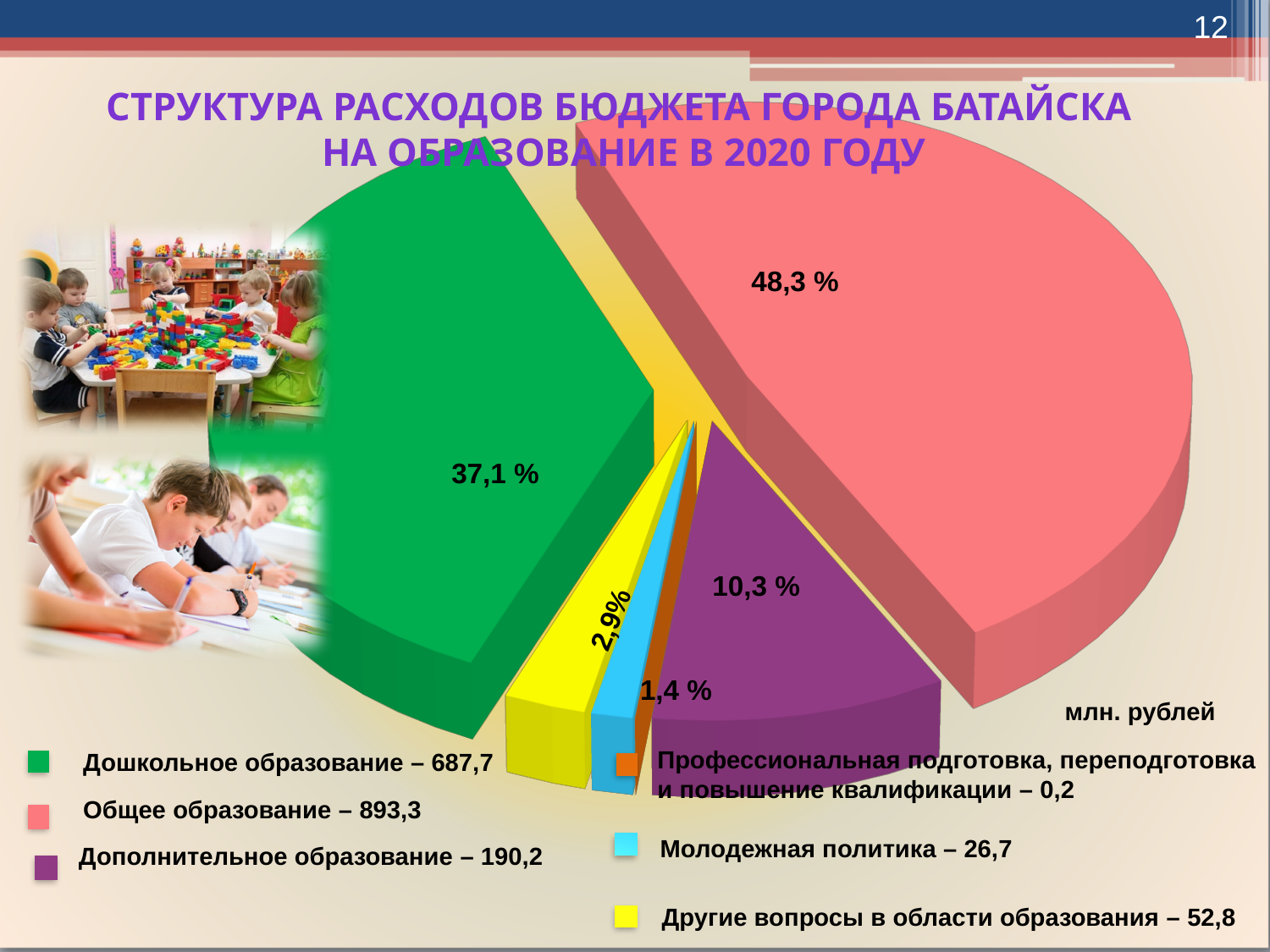
Which category has the largest share of the pie? Общее образование What share of the pie does Дополнительное образование take? 10,3 % Which category has the smallest value in the legend? Профессиональная подготовка, переподготовка и повышение квалификации What value in млн. рублей does the legend give for Дошкольное образование? 687,7 What share of the pie does Дошкольное образование take? 37,1 % Which colour represents Дополнительное образование in the pie chart? purple What is the difference in млн. рублей between Общее образование and Дошкольное образование? 205,6 What share of the pie does Общее образование take? 48,3 % What kind of chart is shown on the slide? pie chart How many categories does the legend of the pie chart list? 6 What value in млн. рублей does the legend give for Другие вопросы в области образования? 52,8